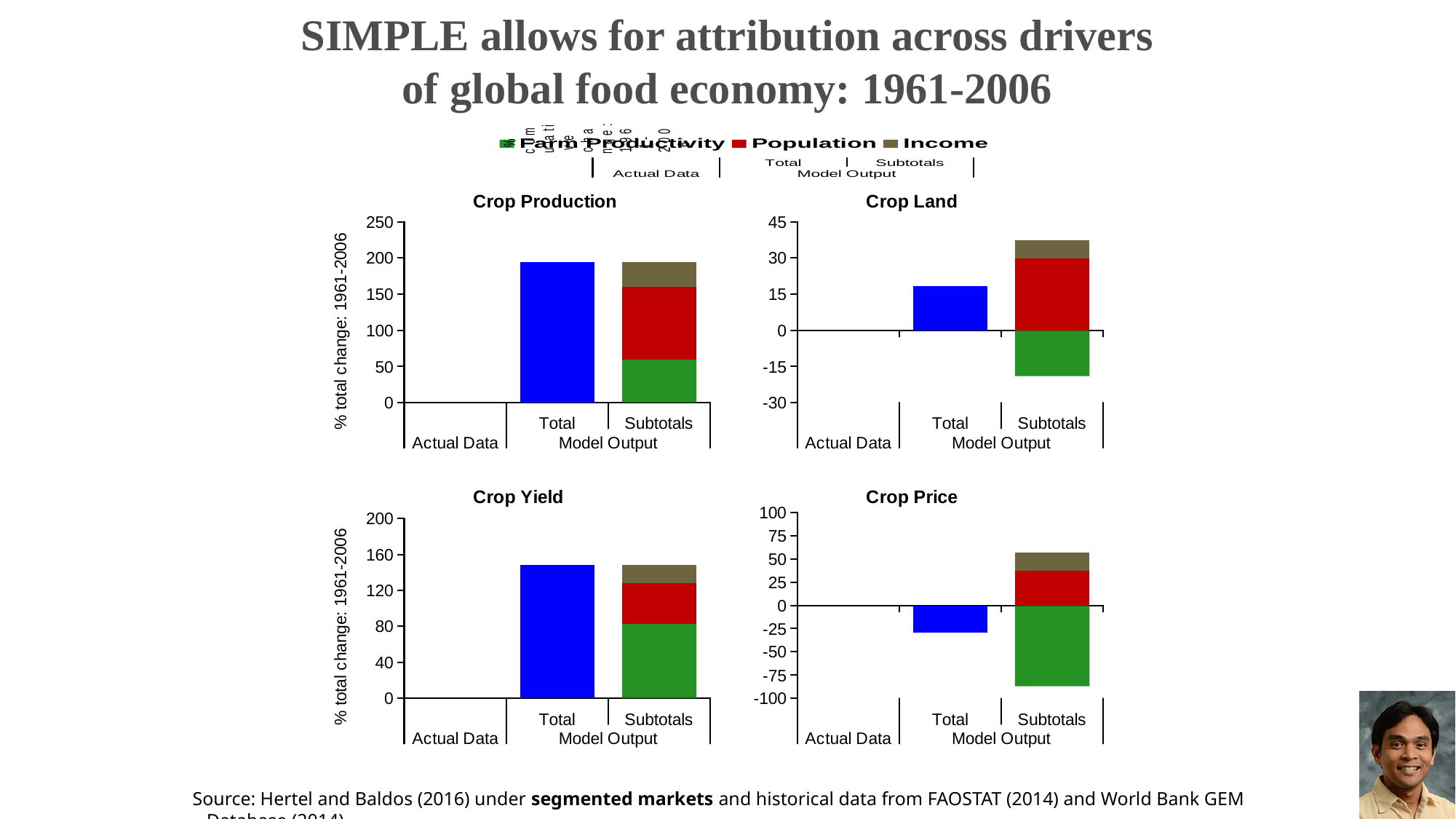
In the Crop Land chart, is the value of the Total bar greater or less than 15? greater In the Crop Yield chart, is the value of the Total bar greater or less than 120? greater What is the y-axis label on the Crop Yield chart? % total change: 1961-2006 How many series does the legend list? 3 What are the three series named in the legend? Farm Productivity, Population, Income In the Crop Price chart, is the Farm Productivity segment of the Subtotals bar greater or less than -50? less How many charts are shown on the slide? 4 What kind of chart is the Crop Production chart? bar chart In the Crop Yield chart, which segment of the Subtotals bar is larger, Farm Productivity or Population? Farm Productivity